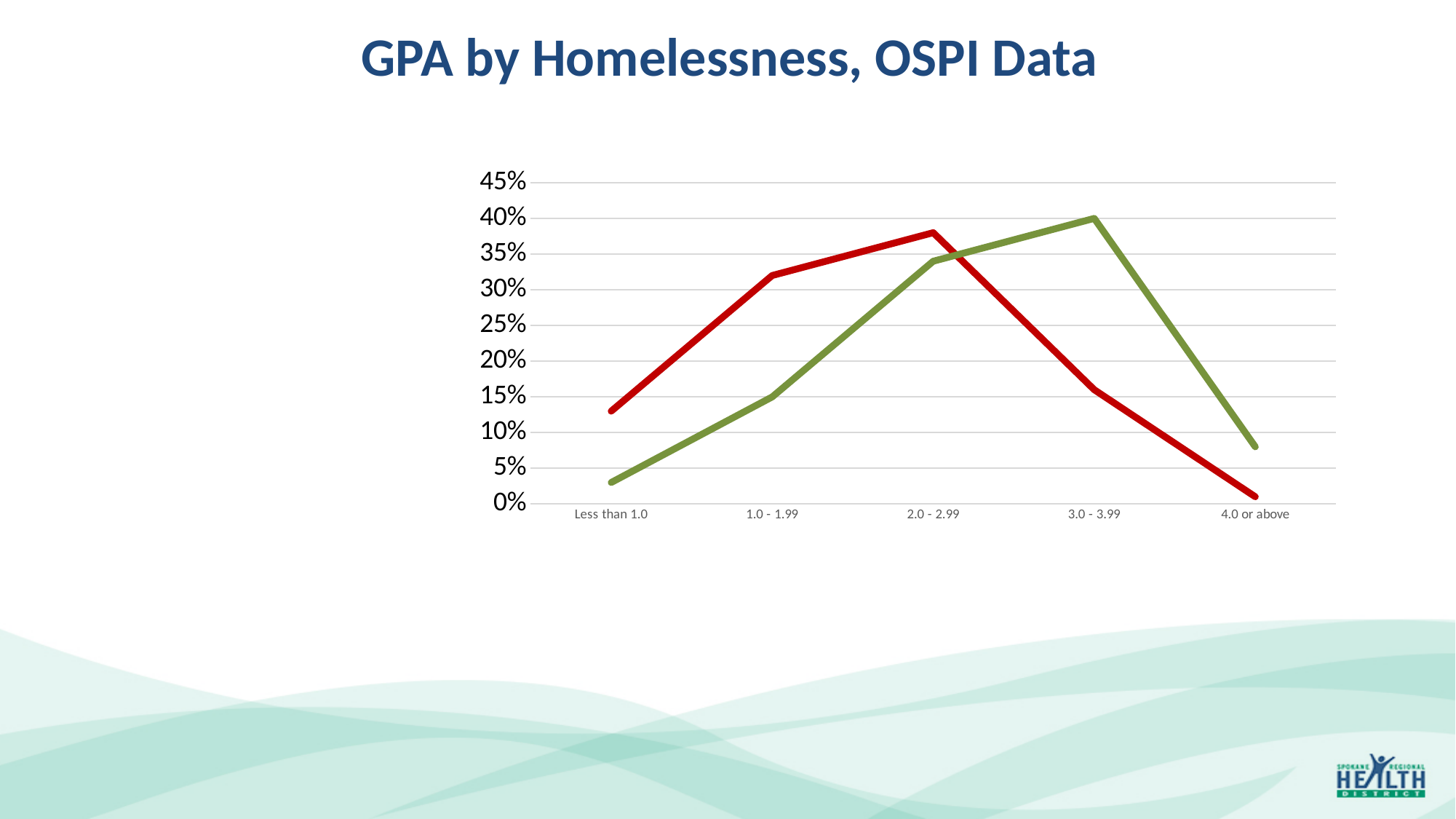
What is the title of the chart? GPA by Homelessness, OSPI Data Is the value of the red line for 1.0 - 1.99 greater or less than 30%? greater In which GPA category does the red line reach its highest value? 2.0 - 2.99 In which GPA category is the green line at its lowest value? Less than 1.0 Does the green line rise or fall from 3.0 - 3.99 to 4.0 or above? fall In which GPA category does the green line reach its highest value? 3.0 - 3.99 How many GPA categories are shown on the x axis? 5 What kind of chart is shown on the slide? line chart What colours are the two lines on the chart? red and green Is the value of the green line for Less than 1.0 greater or less than 5%? less In which GPA category is the red line at its lowest value? 4.0 or above For the 1.0 - 1.99 category, which line has the higher value, red or green? red